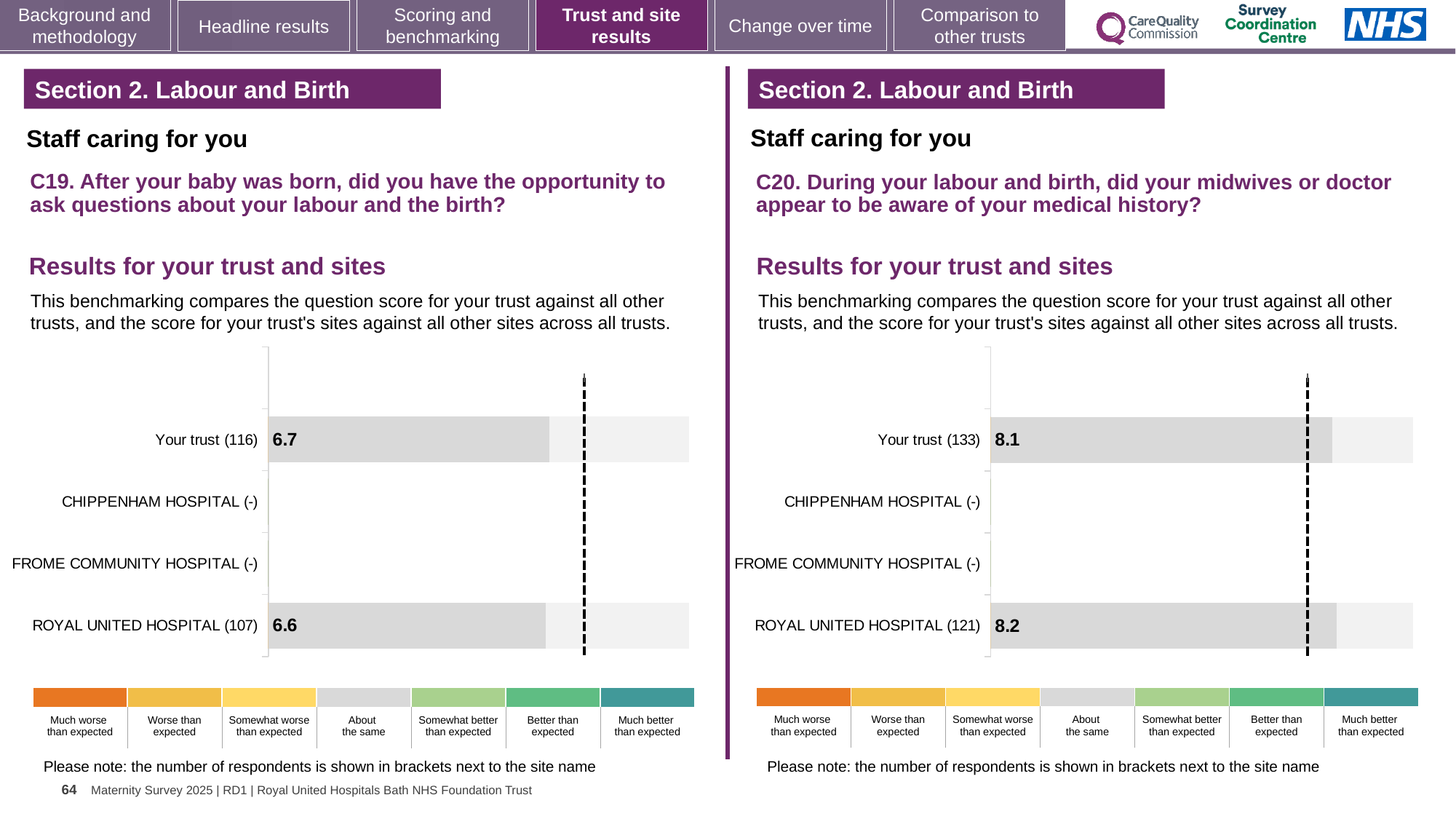
What kind of chart is the C19 chart (left)? Bar chart On the C20 chart (right), what is the score for Royal United Hospital? 8.2 On the C20 chart (right), which has the higher score, Your trust or Royal United Hospital? Royal United Hospital On the C19 chart (left), what is the score for Your trust? 6.7 How many categories are listed on the C20 chart (right)? 4 On the C19 chart (left), which has the higher score, Your trust or Royal United Hospital? Your trust On the C19 chart (left), what is the score for Royal United Hospital? 6.6 On the C20 chart (right), how many respondents are shown in brackets for Royal United Hospital? 121 On the C20 chart (right), what is the difference between the Royal United Hospital score and the Your trust score? 0.1 On the C19 chart (left), how many respondents are shown in brackets for Your trust? 116 On the C20 chart (right), what is the score for Your trust? 8.1 On the C19 chart (left), what is the difference between the Your trust score and the Royal United Hospital score? 0.1